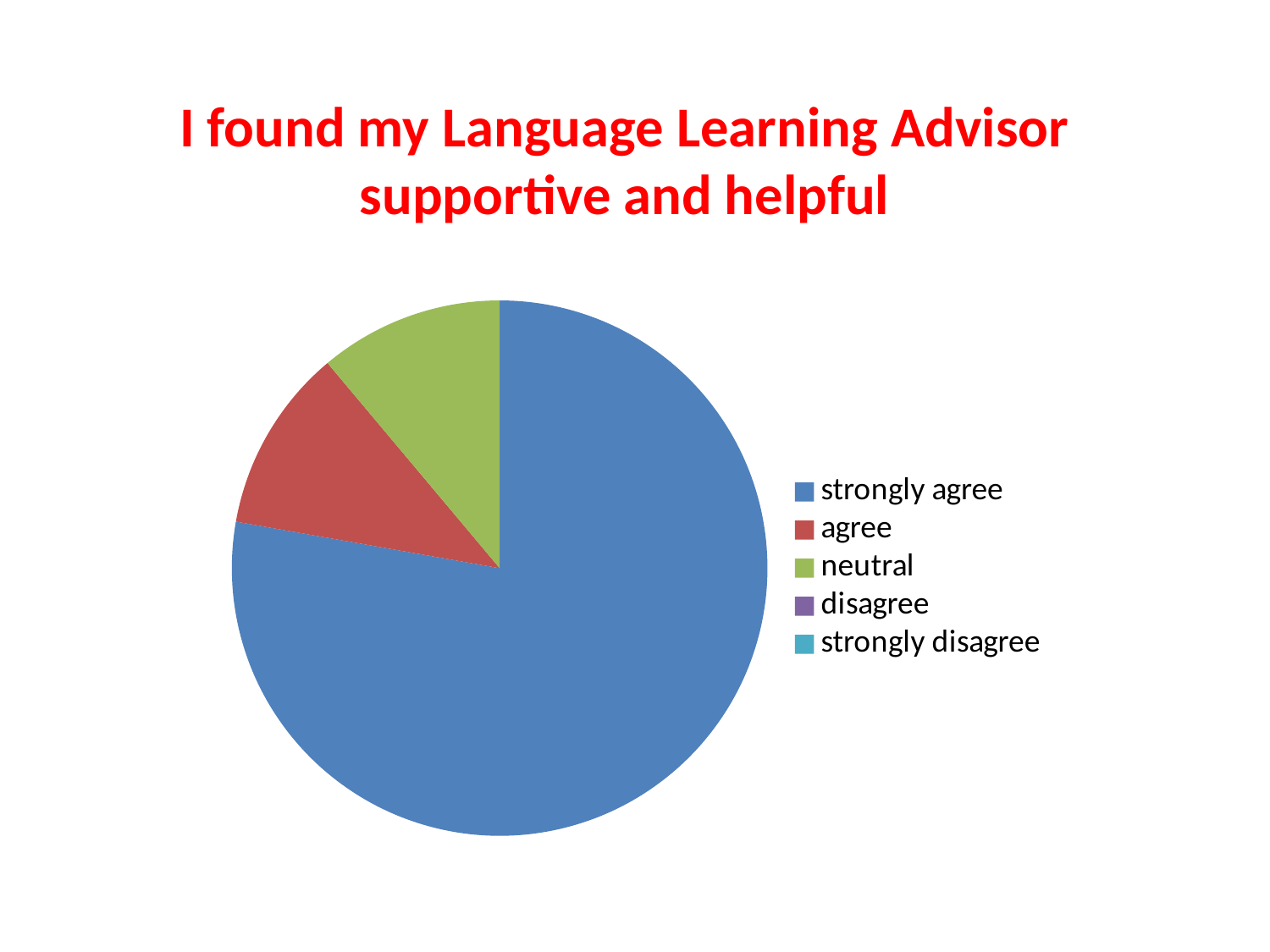
What colour represents the neutral category in the legend? green What kind of chart is shown on the slide? pie chart What is the title of the chart? I found my Language Learning Advisor supportive and helpful How many entries does the legend list? 5 Which category has the largest slice of the pie? strongly agree Which is larger, the slice for strongly agree or the slice for agree? strongly agree How many slices are visible in the pie? 3 Which is larger, the slice for strongly agree or the slice for neutral? strongly agree